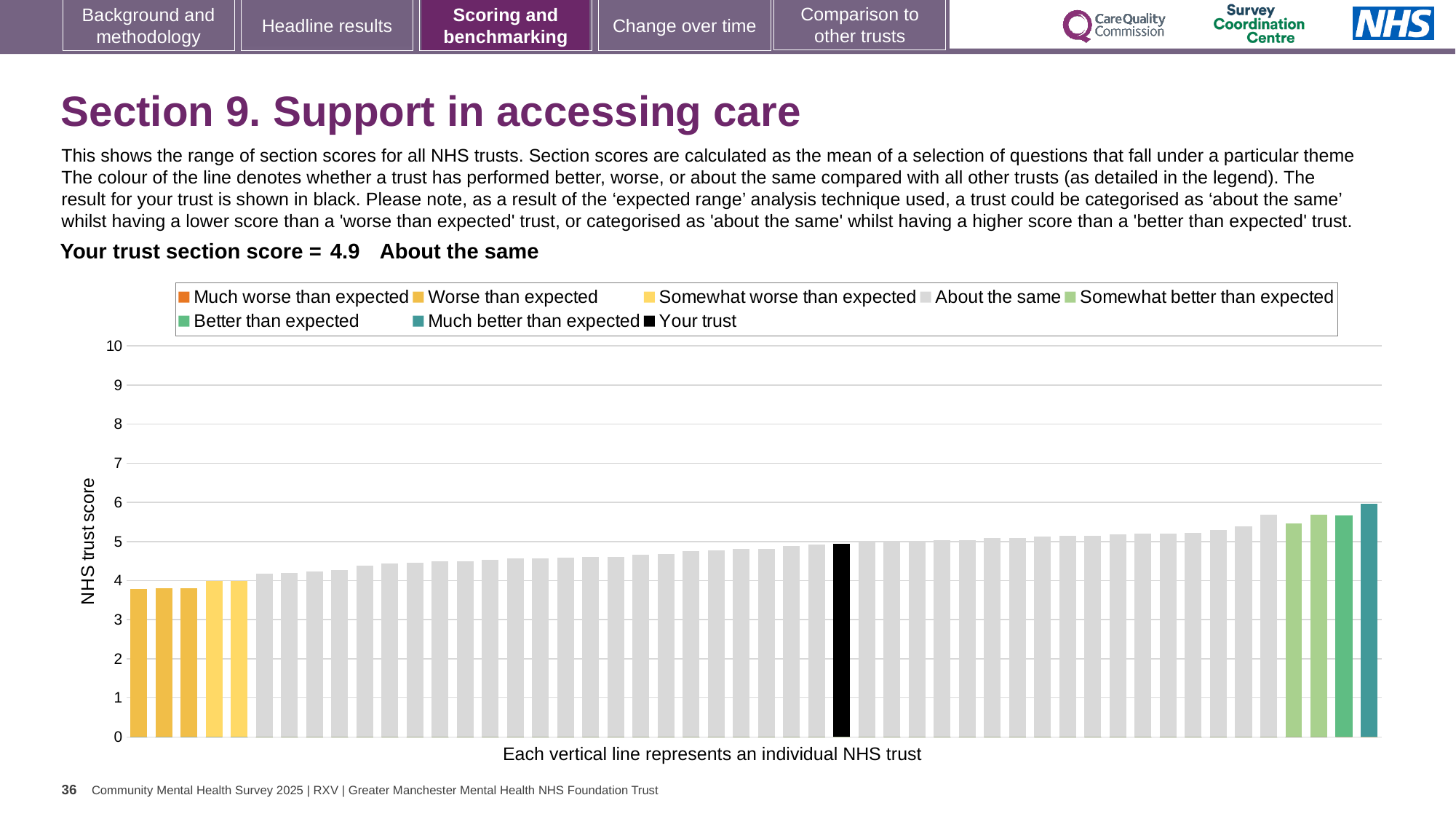
How many bars are coloured as 'Much better than expected'? 1 How many entries does the chart legend list? 8 Which legend category do the shortest bars belong to? Worse than expected Is the value of the shortest bar on the chart greater or less than 5? less Is the value for your trust (the black bar) greater or less than 4? greater Is the value of the tallest bar (the 'Much better than expected' trust) greater or less than 5? greater Which legend category does the tallest bar belong to? Much better than expected What is the label on the y axis of the chart? NHS trust score What is the section score for your trust (the black bar)? 4.9 Is your trust's bar higher or lower than the shortest bar on the chart? higher What kind of chart is shown on the slide? bar chart Do the bar values rise or fall from left to right along the x axis? rise